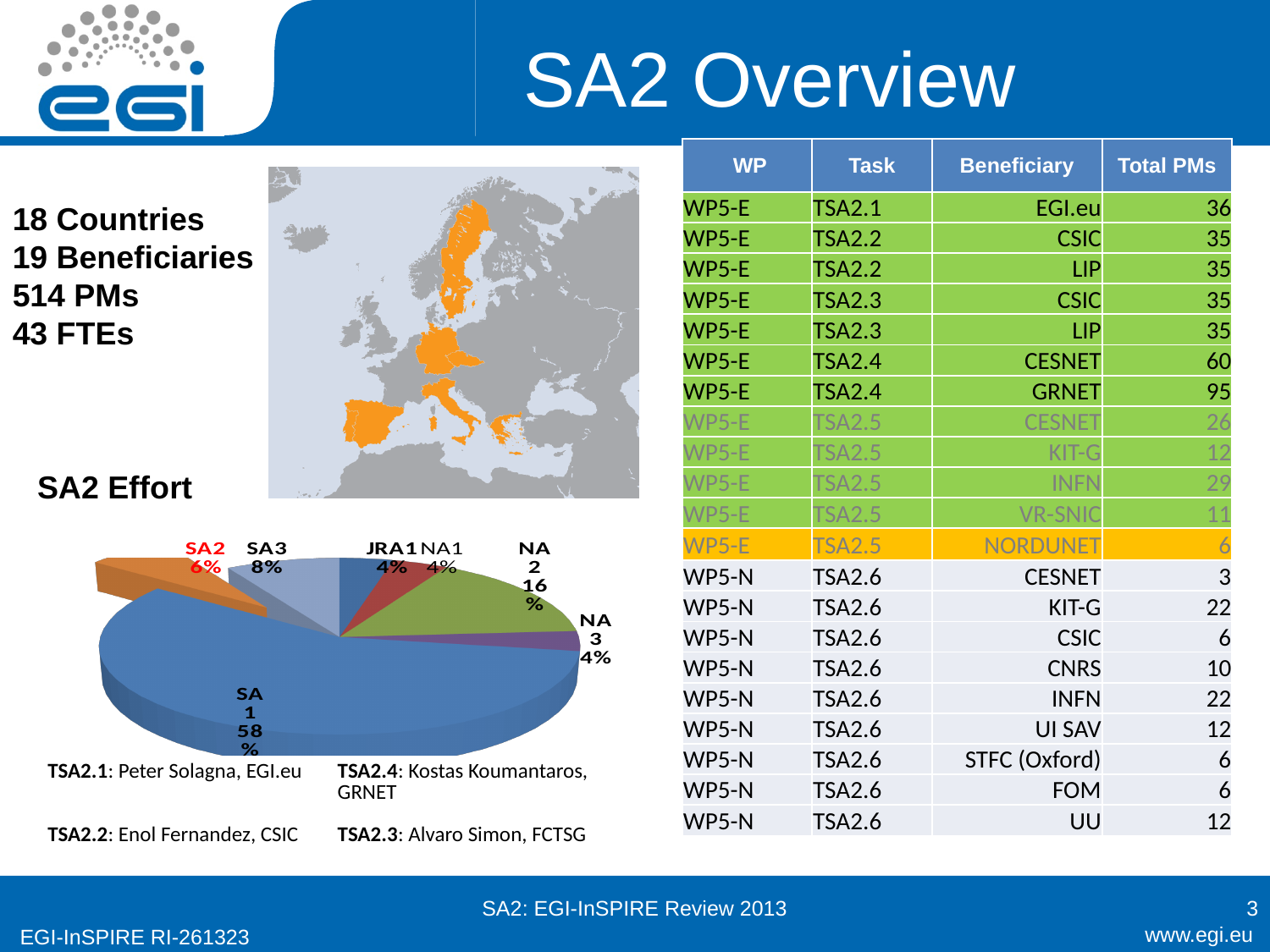
In the SA2 Effort pie chart, what share does SA2 have? 6% In the SA2 Effort pie chart, what share does SA3 have? 8% Which slice is the largest in the SA2 Effort pie chart? SA1 In the SA2 Effort pie chart, how many percentage points larger is SA1 than NA2? 42 Which slice label in the SA2 Effort pie chart is written in red? SA2 In the SA2 Effort pie chart, what share does SA1 have? 58% In the SA2 Effort pie chart, which is larger, NA2 or SA3? NA2 What is the combined share of SA2 and SA3 in the SA2 Effort pie chart? 14% In the SA2 Effort pie chart, which is larger, SA2 or SA3? SA3 What kind of chart is used to show SA2 Effort? Pie chart How many slices does the SA2 Effort pie chart have? 7 In the SA2 Effort pie chart, what share does NA2 have? 16%